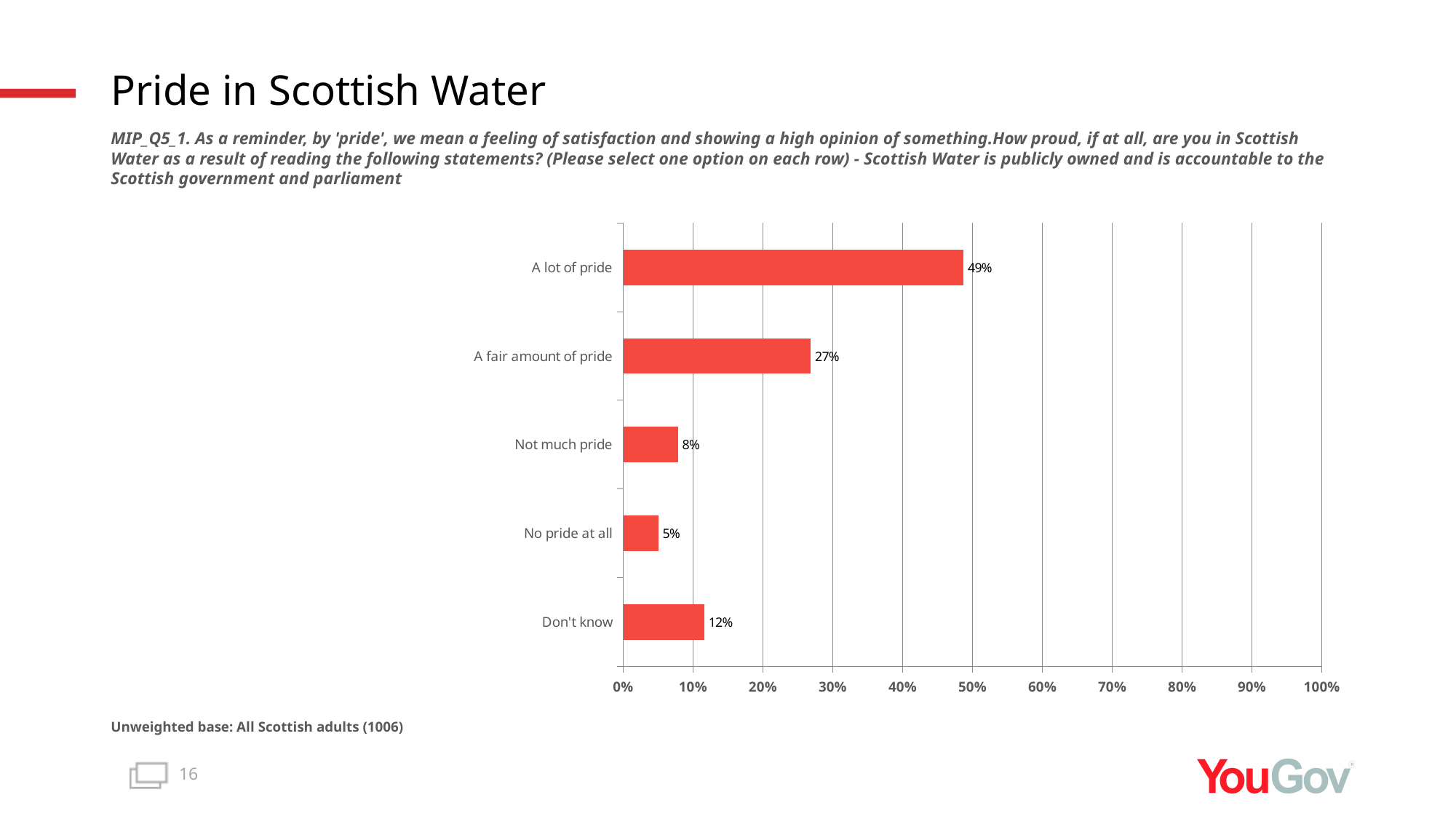
What percentage of respondents answered 'Don't know'? 12% Which category has the lowest value? No pride at all What is the difference between 'A lot of pride' and 'A fair amount of pride'? 22% What percentage of respondents said they feel 'A lot of pride'? 49% Which category has the highest value? A lot of pride What is the difference between 'Not much pride' and 'No pride at all'? 3% What kind of chart is shown on the slide? Bar chart Which is larger, 'Don't know' or 'Not much pride'? Don't know How many categories are shown in the chart? 5 What is the unweighted base stated below the chart? All Scottish adults (1006) What is the value for 'A fair amount of pride'? 27% Is the value for 'A lot of pride' greater or less than 50%? less